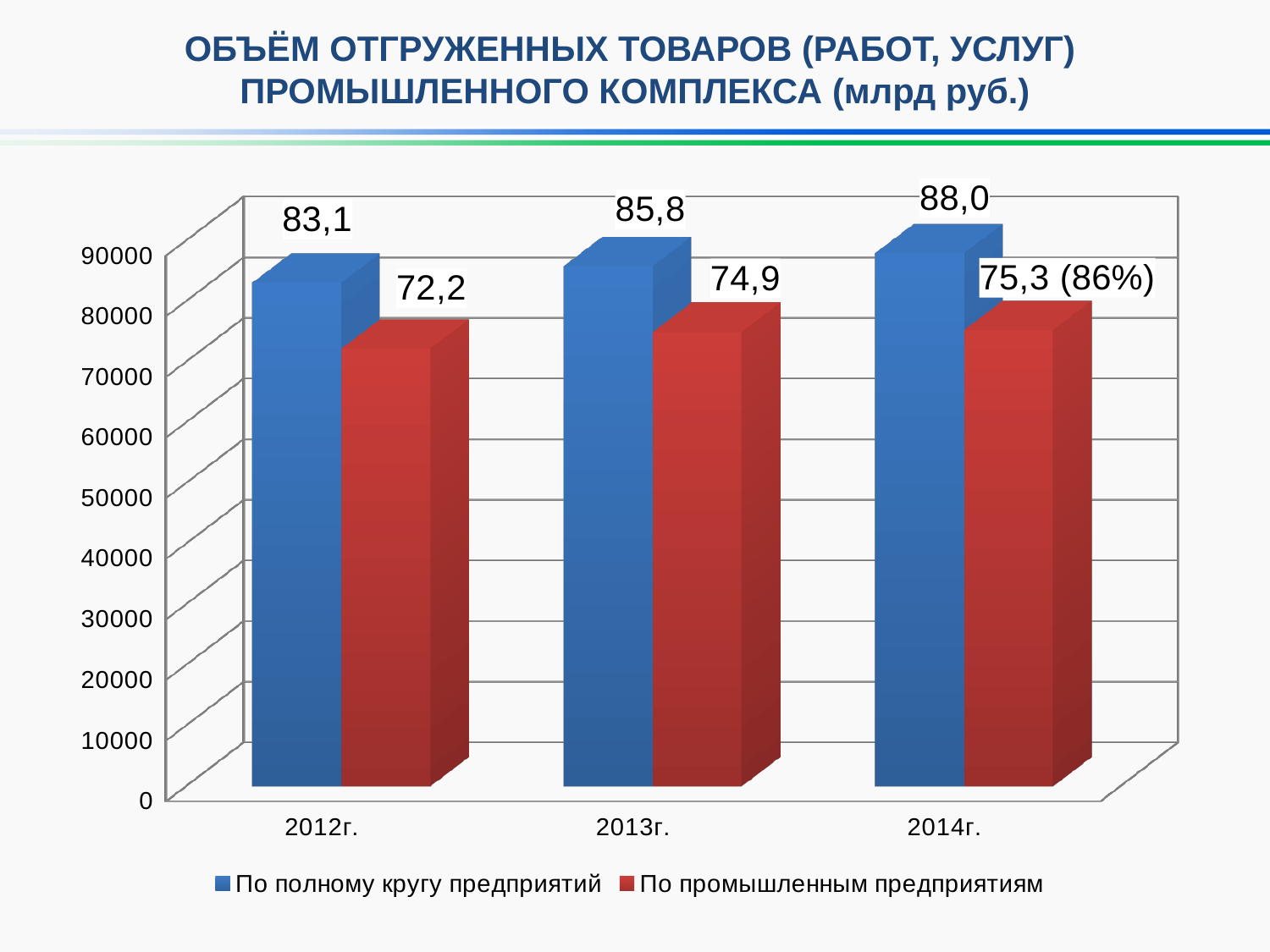
What is the value for 'По полному кругу предприятий' in 2014г.? 88,0 Is the bar for 'По промышленным предприятиям' in 2012г. greater or less than 80000 on the axis? less In which year is the value for 'По полному кругу предприятий' highest? 2014г. Which is larger in 2013г.: 'По полному кругу предприятий' or 'По промышленным предприятиям'? По полному кругу предприятий What is the difference between 'По полному кругу предприятий' and 'По промышленным предприятиям' in 2012г.? 10,9 What is the value for 'По промышленным предприятиям' in 2013г.? 74,9 How many years are shown on the x axis? 3 In which year is the value for 'По промышленным предприятиям' lowest? 2012г. What is the value for 'По полному кругу предприятий' in 2012г.? 83,1 Do the values for 'По полному кругу предприятий' rise or fall from 2012г. to 2014г.? rise What is the data label shown for 'По промышленным предприятиям' in 2014г.? 75,3 (86%) How many series does the legend list? 2